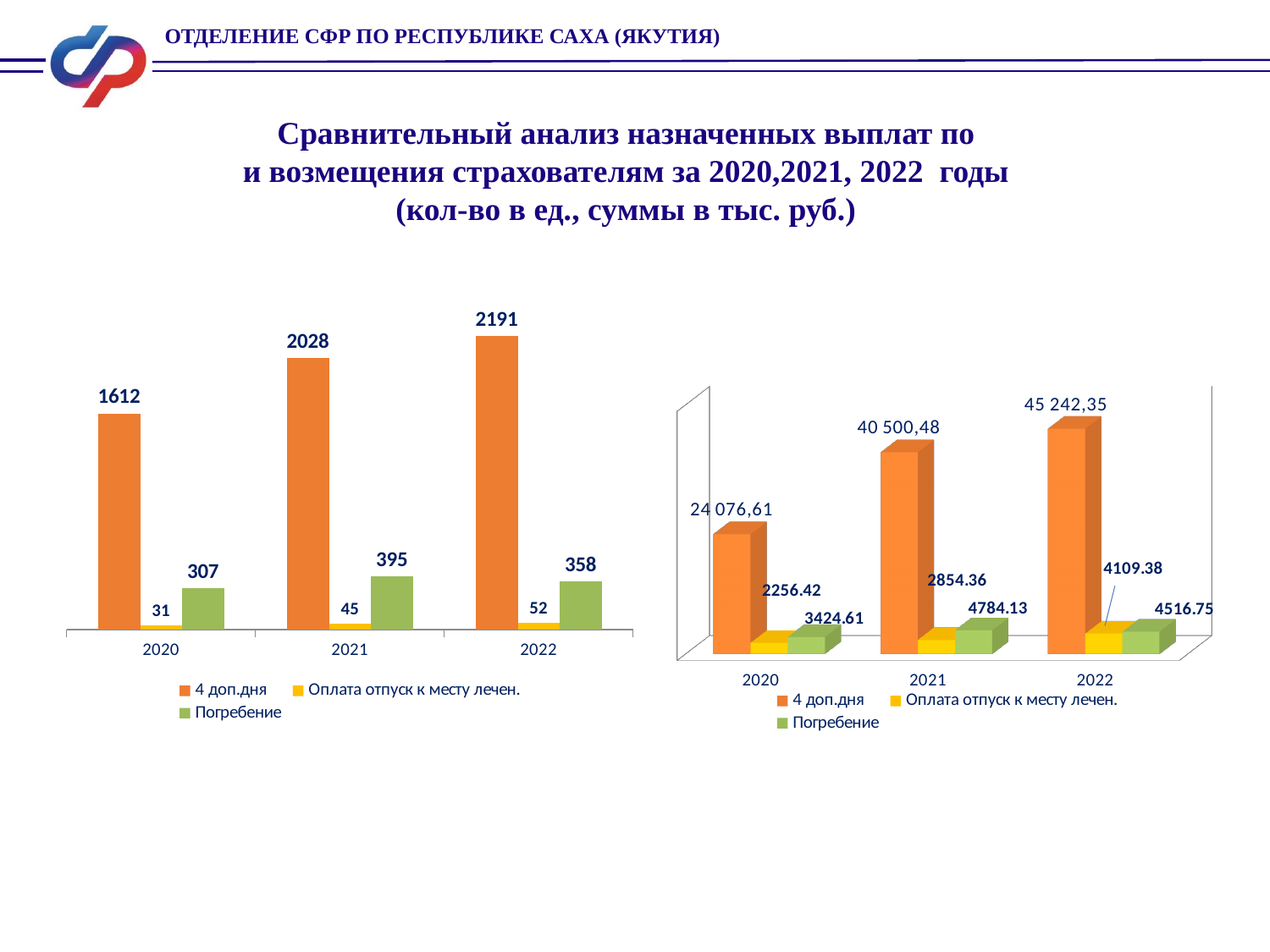
In the left chart, what is the value for "Погребение" in 2020? 307 In the right chart, what is the value for "Погребение" in 2021? 4784.13 In the right chart, what is the value for "4 доп.дня" in 2021? 40 500,48 How many series does the legend of the right chart list? 3 In the left chart, what is the value for "Оплата отпуск к месту лечен." in 2022? 52 In the right chart, is the value for "Погребение" larger in 2021 or in 2022? 2021 In the left chart, which year has the lowest value for "Погребение"? 2020 In the left chart, what is the value for "4 доп.дня" in 2021? 2028 In the right chart, what is the value for "Оплата отпуск к месту лечен." in 2022? 4109.38 In the left chart, which year has the highest value for "4 доп.дня"? 2022 What kind of chart is the left chart? bar chart In the left chart, what is the difference between the "4 доп.дня" values for 2022 and 2020? 579